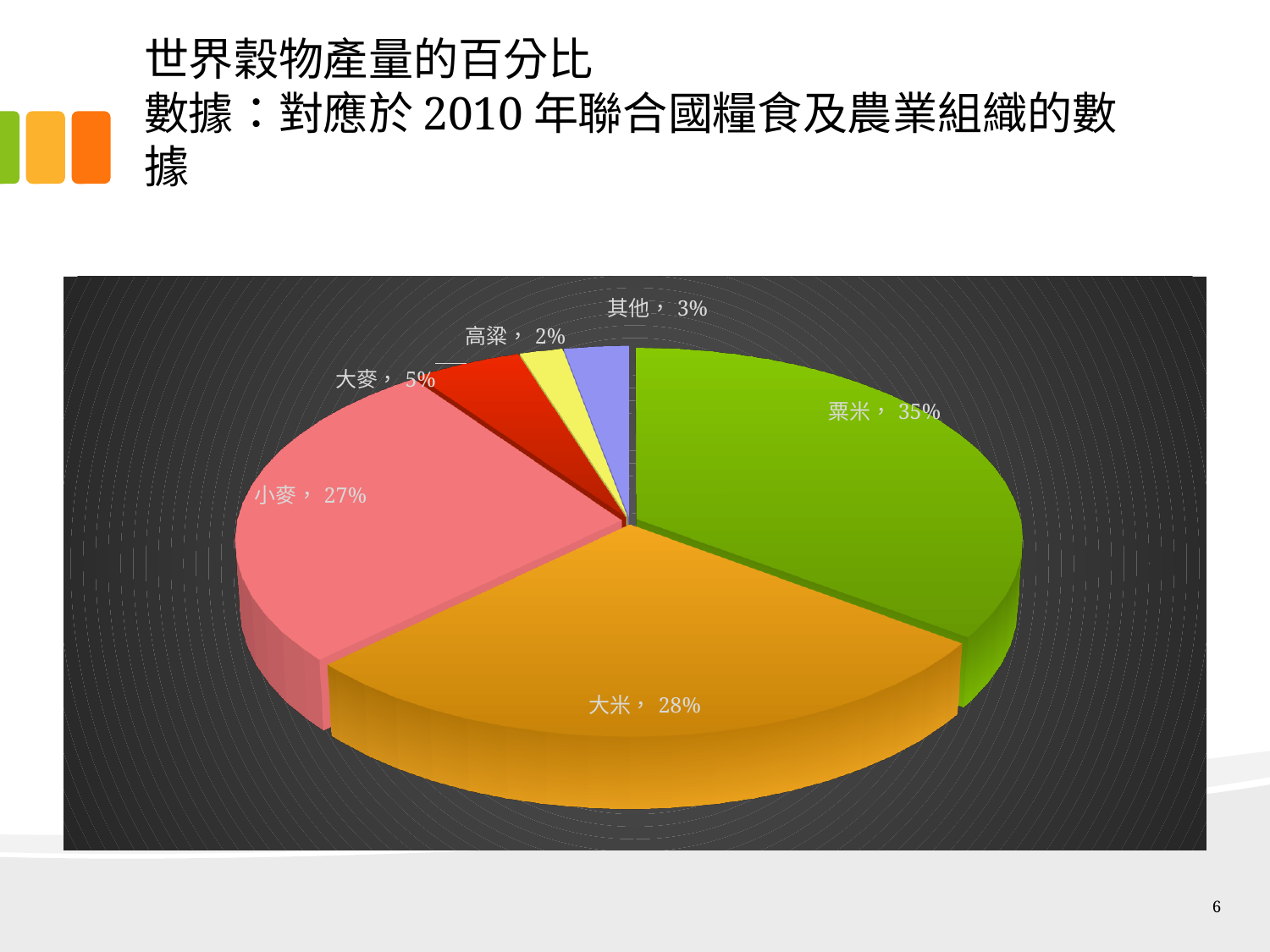
What colour is the 大米 slice? Orange What is the difference between the shares of 粟米 and 大米? 7% Which is larger, the share of 其他 or the share of 高粱? 其他 What percentage of world grain production does 粟米 account for? 35% What is the value shown for 小麥? 27% What is the value shown for 高粱? 2% Which category has the smallest share of the pie? 高粱 What is the value shown for 大米? 28% What is the value shown for 大麥? 5% How many slices does the pie chart have? 6 What kind of chart is shown on the slide? Pie chart Which category has the largest share of the pie? 粟米